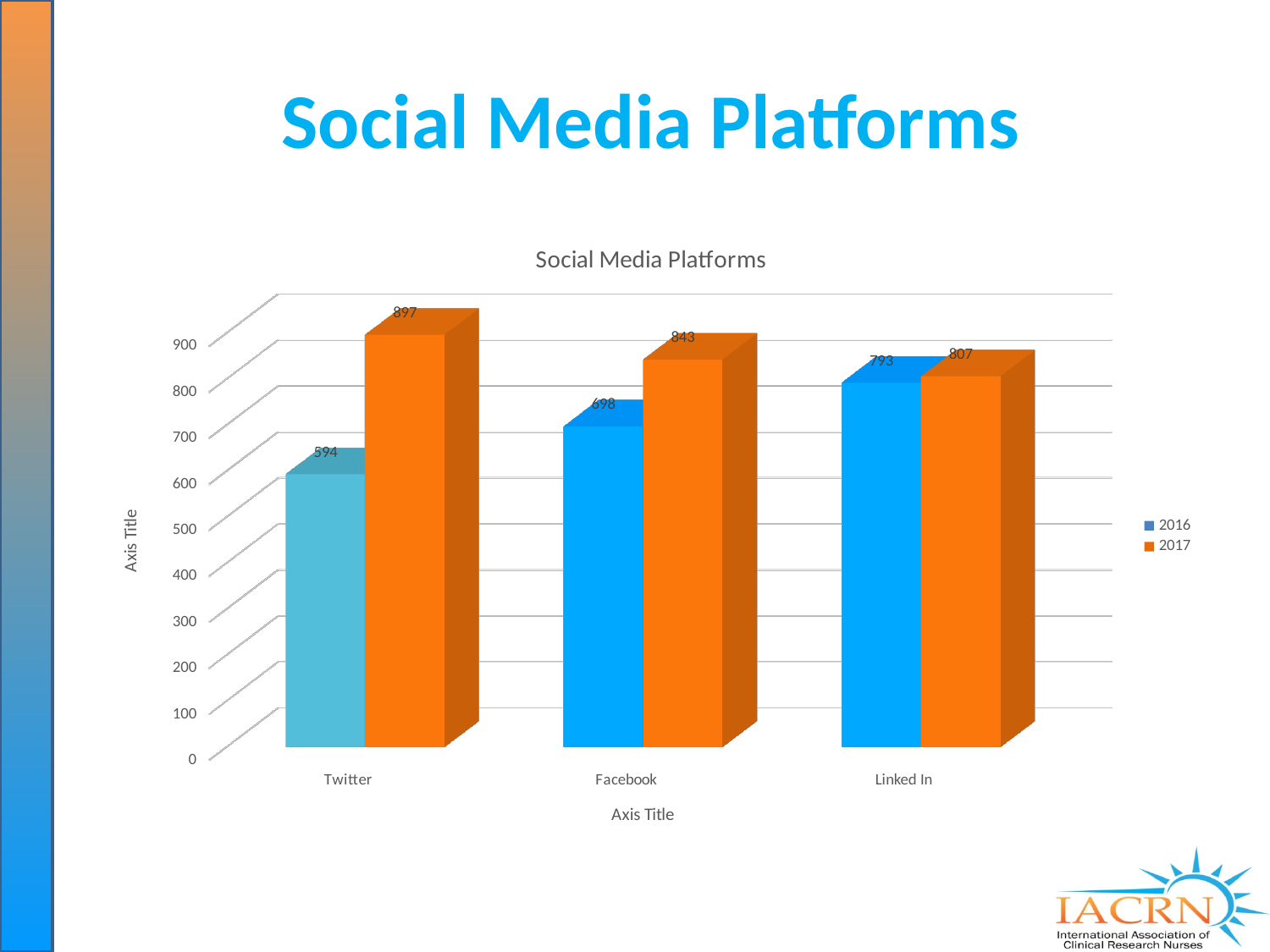
What is the title of the chart? Social Media Platforms What is the 2016 value for Twitter? 594 What kind of chart is shown? Bar chart Which platform has the lowest 2016 value? Twitter How many platforms are shown on the x axis? 3 Which is larger, the 2016 value for Linked In or the 2016 value for Facebook? Linked In Which platform has the highest 2017 value? Twitter What is the 2016 value for Linked In? 793 What is the 2017 value for Facebook? 843 What is the difference between the 2017 and 2016 values for Twitter? 303 What is the difference between the 2017 and 2016 values for Facebook? 145 How many series does the legend list? 2